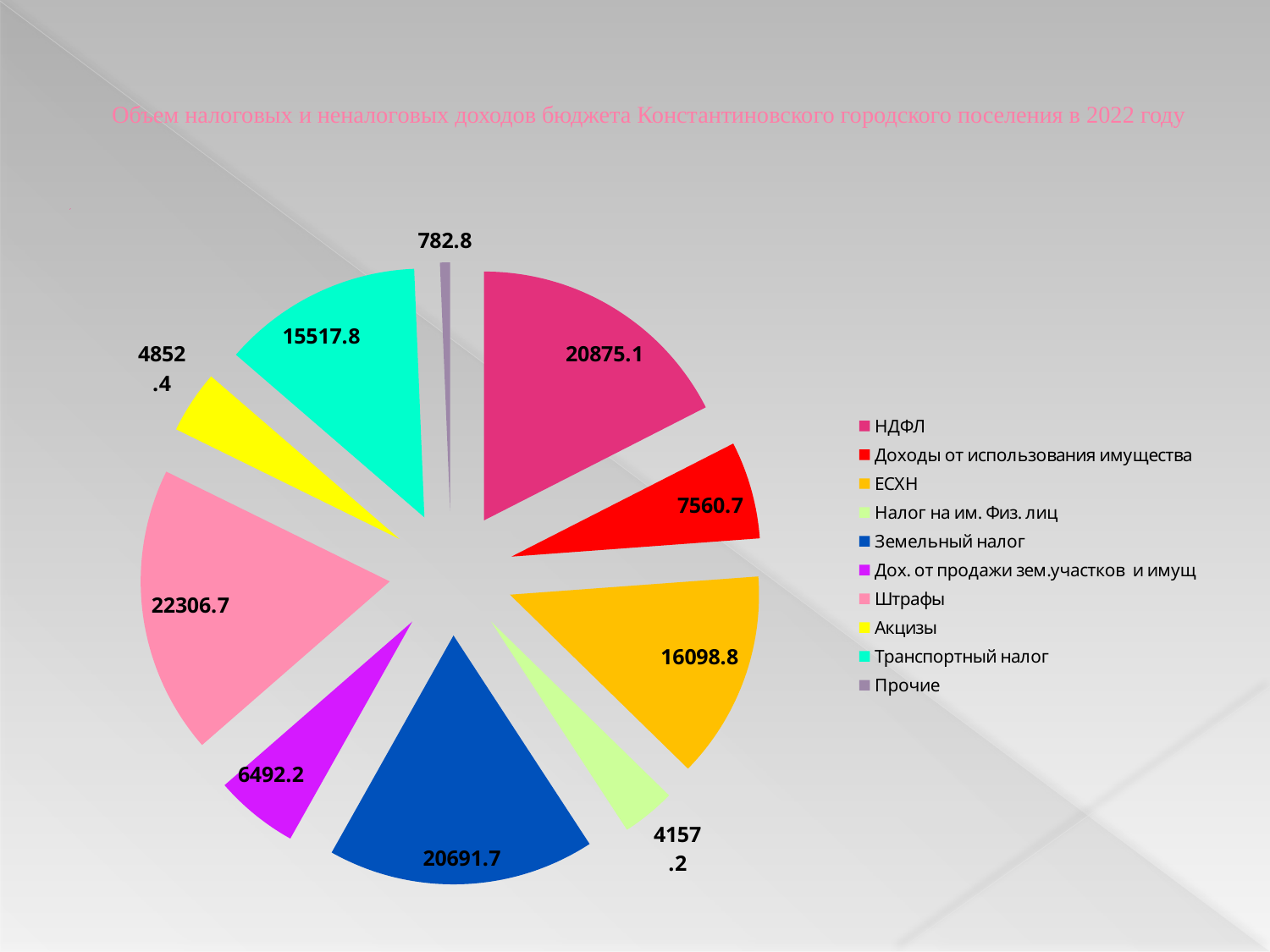
What is the difference between the values for НДФЛ and Земельный налог? 183.4 What type of chart is shown on the slide? Pie chart How many categories does the legend list? 10 Which category has the largest value? Штрафы What is the value for НДФЛ? 20875.1 What is the value for Дох. от продажи зем.участков и имущ? 6492.2 What is the value for Штрафы? 22306.7 What colour is the slice for ЕСХН? Orange Which is larger, the value for Акцизы or the value for Налог на им. Физ. лиц? Акцизы Which category has the smallest value? Прочие What is the value for Прочие? 782.8 What is the value for Транспортный налог? 15517.8